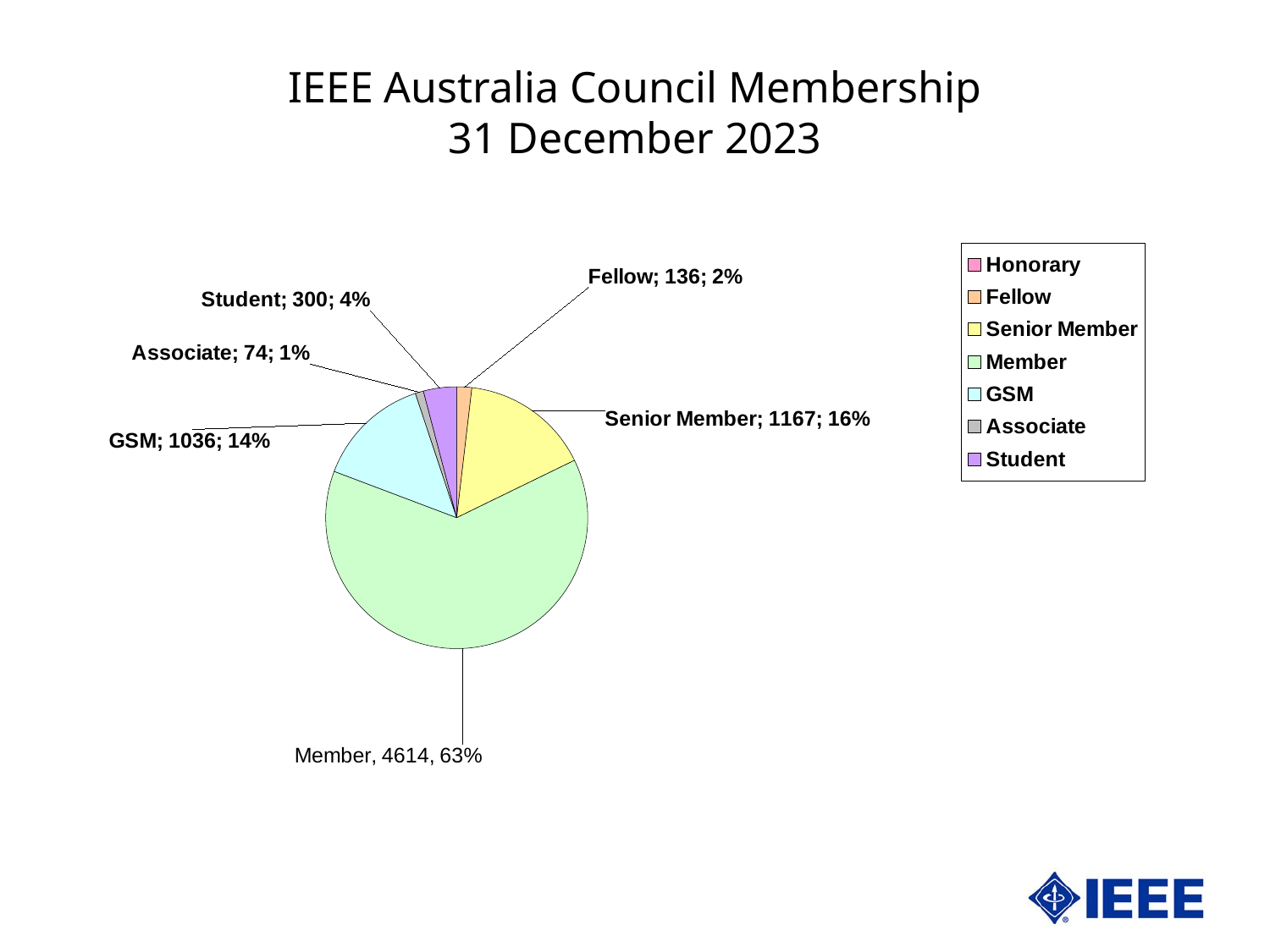
How many members are in the GSM category? 1036 What colour is the Senior Member slice? yellow How many entries does the legend list? 7 Which category has the largest slice of the pie? Member Which is larger, the Fellow count or the Student count? Student What share of the pie does the Member slice represent? 63% How many members are in the Senior Member category? 1167 What is the title of the chart? IEEE Australia Council Membership 31 December 2023 Which labelled category has the smallest count? Associate What kind of chart is shown on the slide? pie chart What is the difference in count between Senior Member and GSM? 131 What percentage of membership is Student? 4%